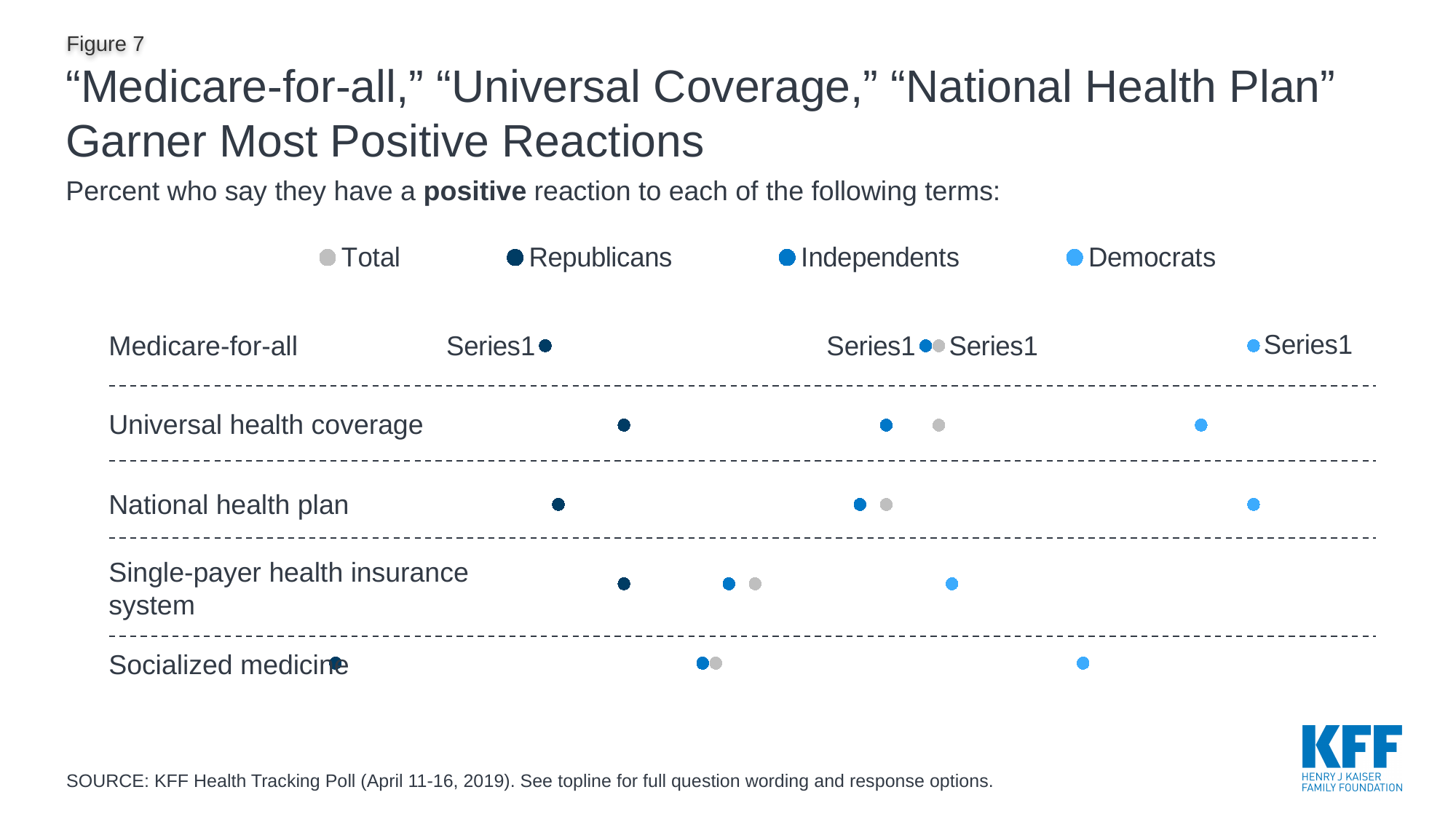
Which term has the lowest value for Republicans? Socialized medicine For Socialized medicine, is the value for Democrats or Republicans larger? Democrats For Single-payer health insurance system, which group has the lowest value? Republicans For Universal health coverage, is the value for Independents or Republicans larger? Independents How many terms (categories) are plotted on the chart? 5 Which term has the lowest value for Democrats? Single-payer health insurance system Which groups are listed in the chart legend? Total, Republicans, Independents, Democrats How many series does the legend list? 4 For National health plan, is the value for Total or Republicans larger? Total For Socialized medicine, which group has the highest value? Democrats What is the source of the data shown in the chart? KFF Health Tracking Poll (April 11-16, 2019) What kind of chart is shown on the slide? Dot plot